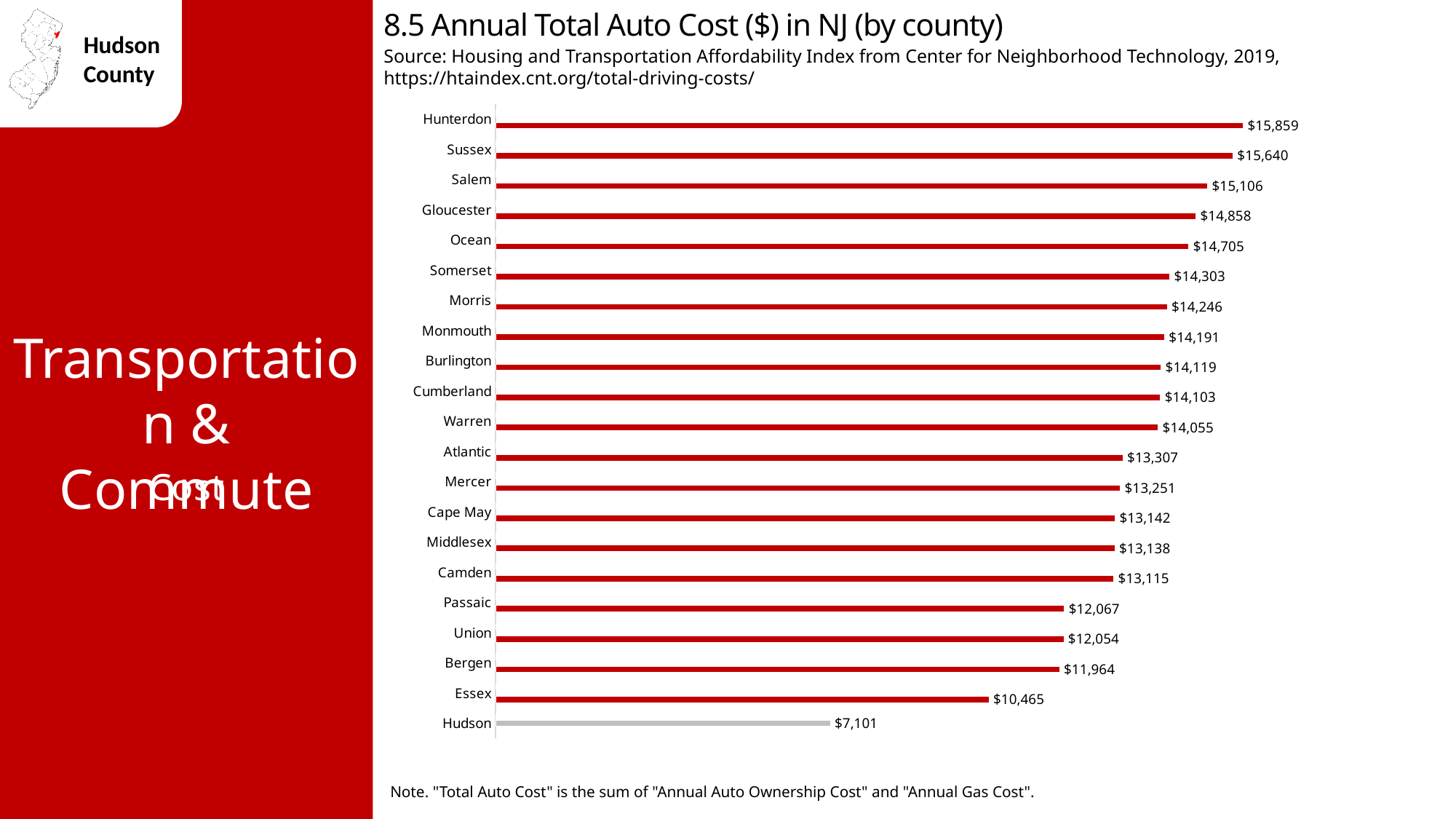
Which county's bar is shown in a different colour (grey) from the others? Hudson What is the difference in annual total auto cost between Essex and Hudson? $3,364 What type of chart is shown on the slide? Bar chart Which county has a higher annual total auto cost, Passaic or Essex? Passaic What is the annual total auto cost for Hudson County? $7,101 What is the difference in annual total auto cost between Hunterdon and Hudson? $8,758 What is the annual total auto cost for Bergen County? $11,964 How many counties are shown in the chart? 21 What is the annual total auto cost for Morris County? $14,246 Which county has the lowest annual total auto cost? Hudson Which county has the highest annual total auto cost? Hunterdon Which county has a higher annual total auto cost, Salem or Ocean? Salem